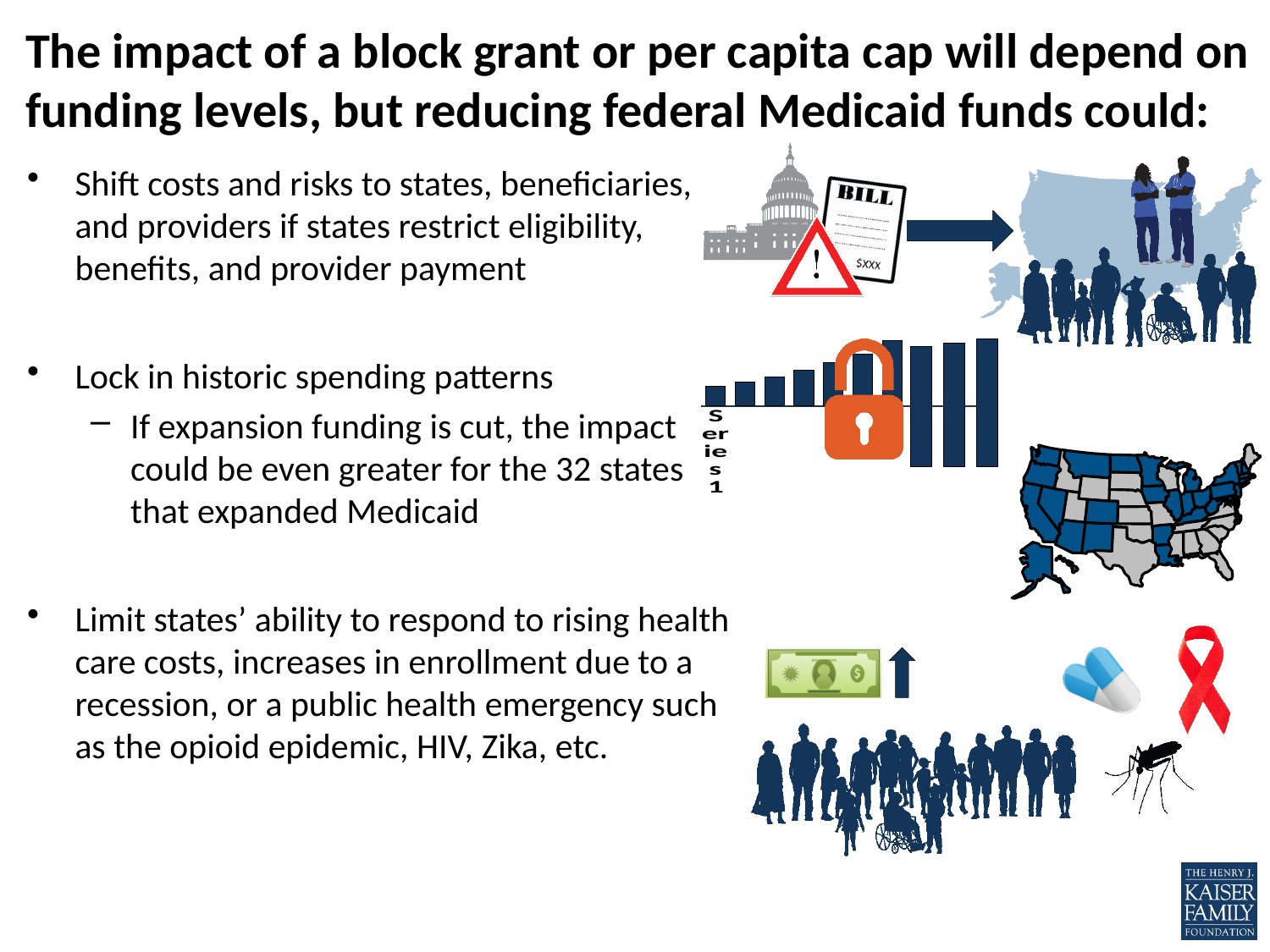
What is the name of the series shown in the bar chart behind the lock icon? Series 1 How many series does the bar chart behind the lock icon show? 1 What kind of chart is shown in the middle of the right side of the slide, behind the orange lock icon? bar chart In the bar chart behind the lock icon, do the bars rise or fall from left to right? rise What colour are the bars in the bar chart behind the lock icon? dark blue